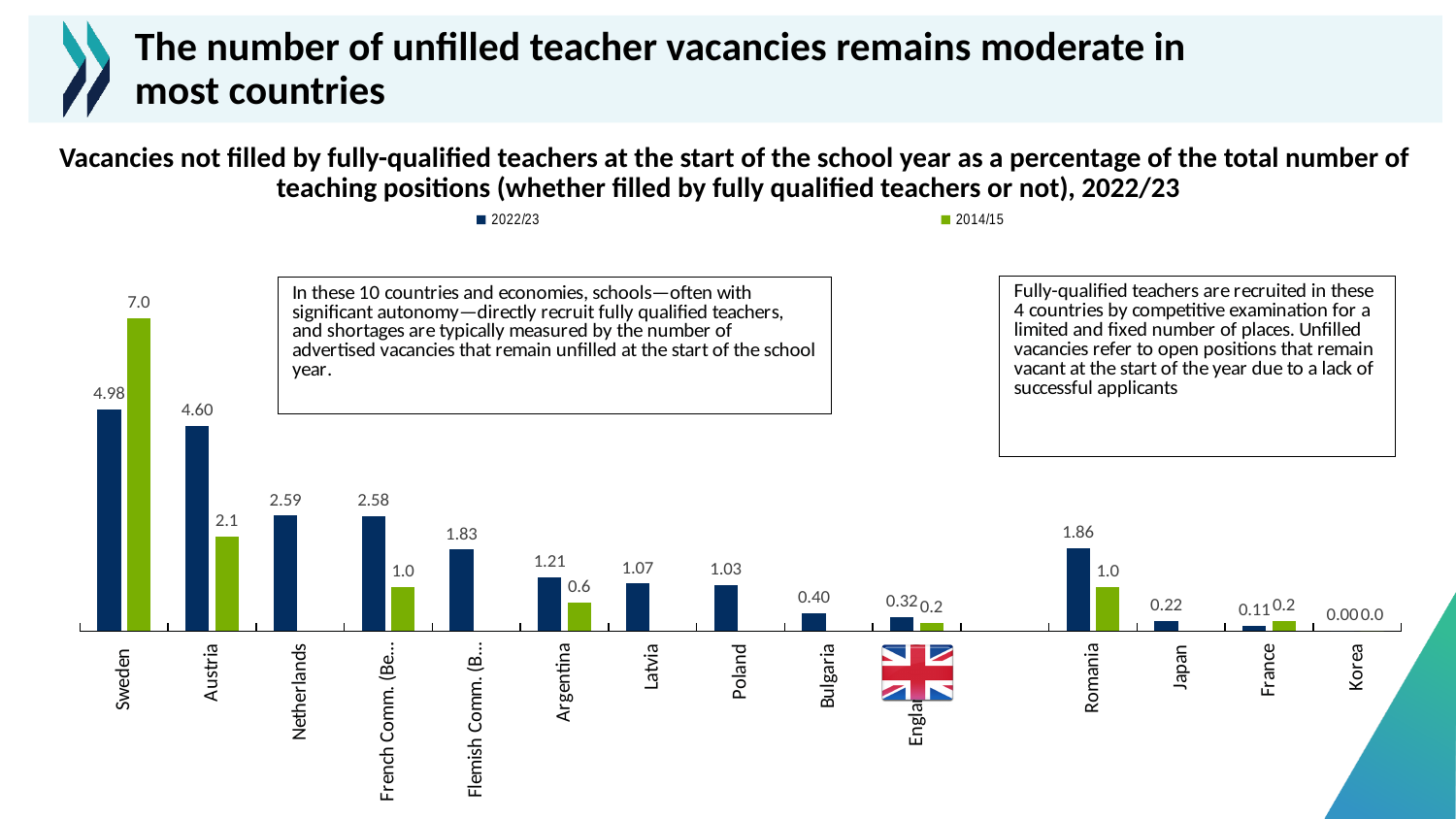
Which country has the highest 2022/23 value? Sweden How many series does the legend list? 2 What is the 2022/23 value for Austria? 4.60 How many countries or economies are shown on the x axis? 14 What is the 2022/23 value for Sweden? 4.98 What is the 2022/23 value for Romania? 1.86 How much higher is Sweden's 2014/15 value than its 2022/23 value? 2.02 For Austria, which series has the larger value, 2022/23 or 2014/15? 2022/23 What kind of chart is shown on the slide? Bar chart Which country has the lowest 2022/23 value? Korea What is the 2014/15 value for Sweden? 7.0 What is the difference between the 2022/23 values for Netherlands and Poland? 1.56